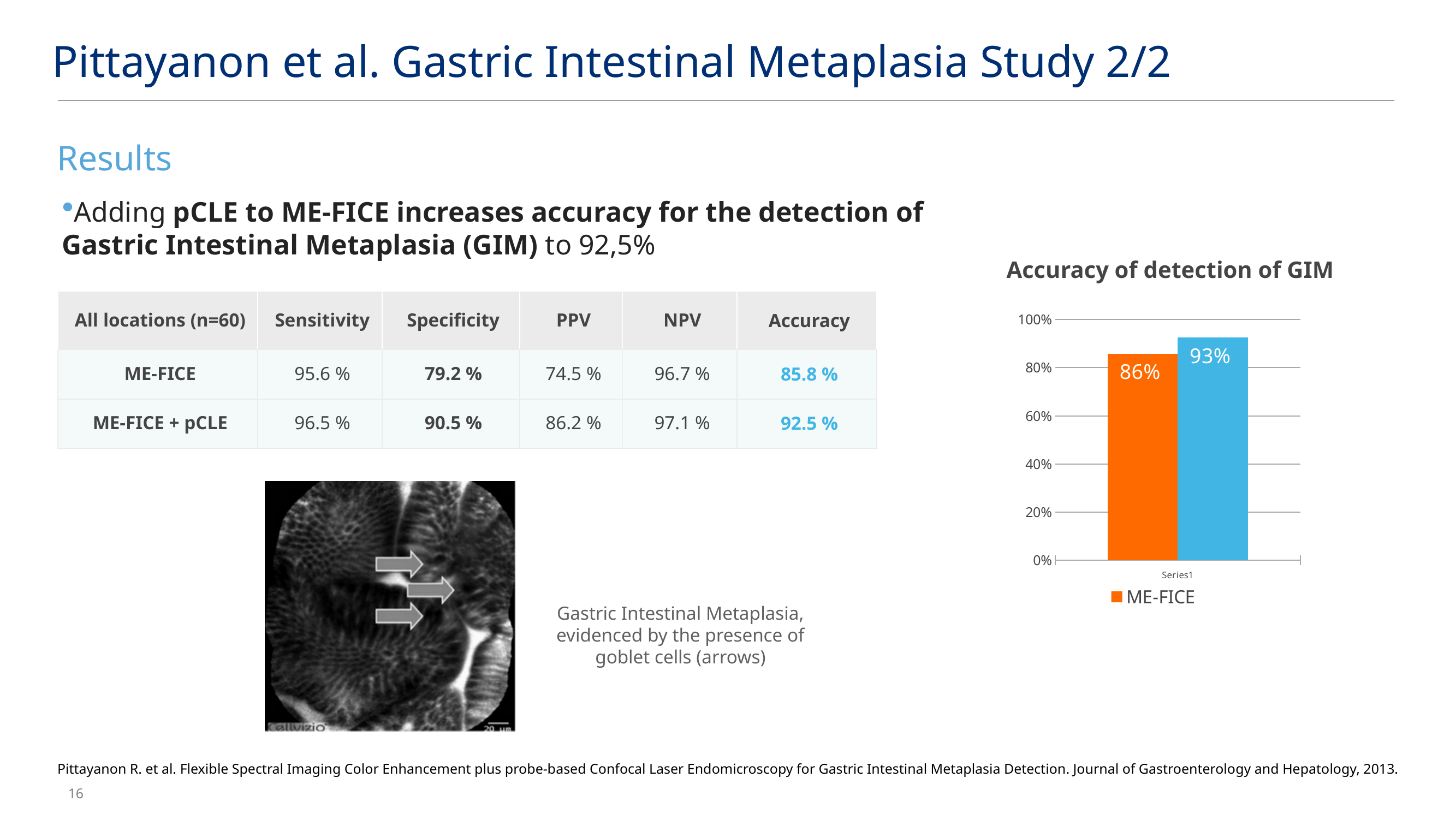
In the chart 'Accuracy of detection of GIM', is the value of the blue bar greater or less than 100%? less In the chart 'Accuracy of detection of GIM', what colour is the ME-FICE bar? orange In the chart 'Accuracy of detection of GIM', what is the difference between the blue bar's value and the ME-FICE value? 7 percentage points In the chart 'Accuracy of detection of GIM', is the value for ME-FICE greater or less than 80%? greater How many entries does the legend of the chart 'Accuracy of detection of GIM' list? 1 What kind of chart is 'Accuracy of detection of GIM'? bar chart How many bars are plotted in the chart 'Accuracy of detection of GIM'? 2 In the chart 'Accuracy of detection of GIM', which bar is taller, the orange ME-FICE bar or the blue bar? the blue bar In the chart 'Accuracy of detection of GIM', what is the value shown for ME-FICE? 86% In the chart 'Accuracy of detection of GIM', what is the highest value shown on the vertical axis? 100% What is the title of the chart on the right side of the slide? Accuracy of detection of GIM In the chart 'Accuracy of detection of GIM', what value is labelled on the blue bar? 93%